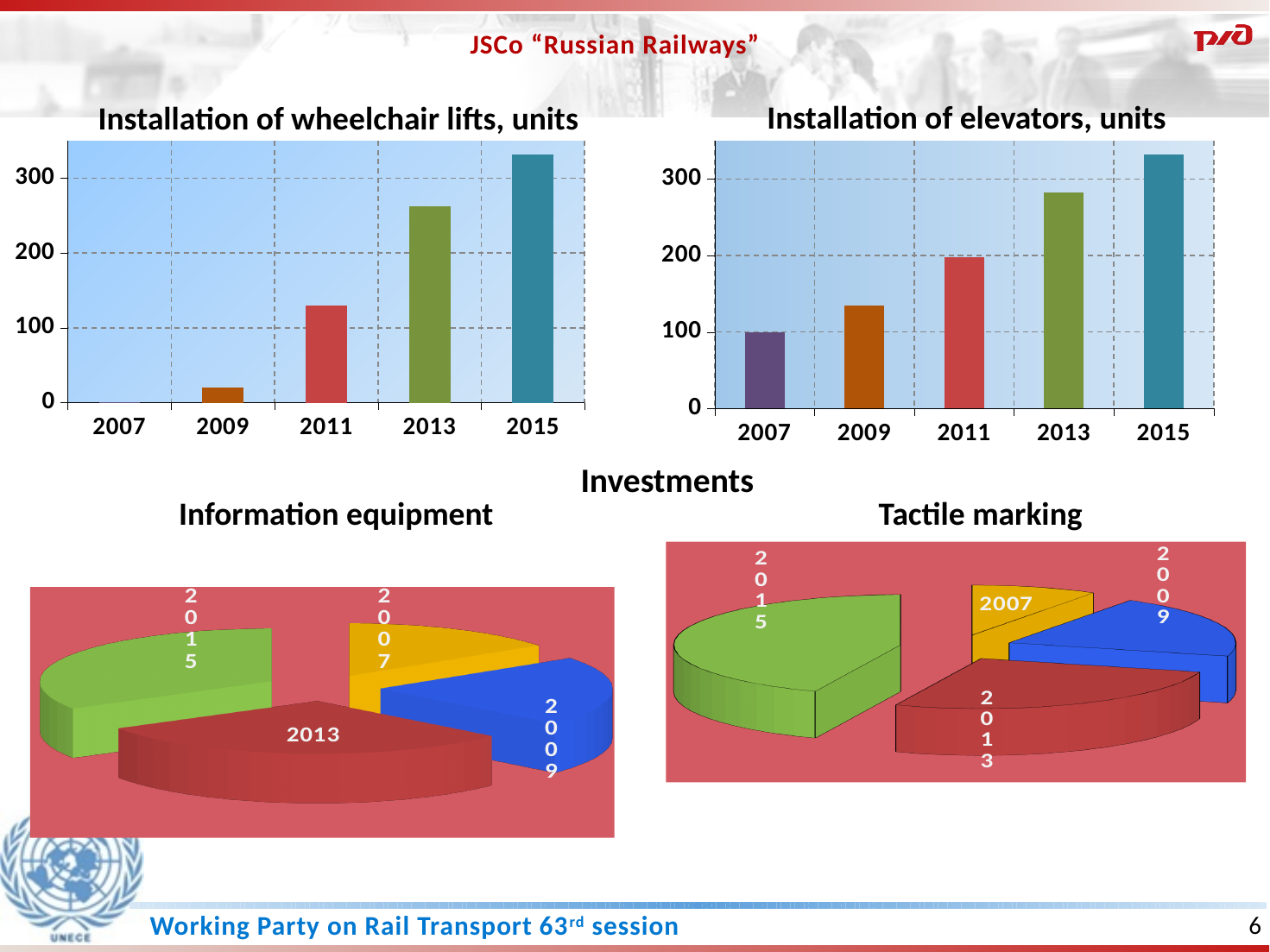
In the "Installation of elevators, units" chart, is the value for 2013 greater or less than 200? greater In the "Installation of wheelchair lifts, units" chart, which year has the highest value? 2015 In the "Installation of wheelchair lifts, units" chart, how many years are shown on the x axis? 5 In the "Installation of elevators, units" chart, which year has the highest value? 2015 In the "Installation of wheelchair lifts, units" chart, do the values rise or fall from 2007 to 2015? rise In the "Installation of wheelchair lifts, units" chart, which year has the lowest value? 2007 In the "Installation of wheelchair lifts, units" chart, is the value for 2013 greater or less than 200? greater In the "Installation of elevators, units" chart, which is larger, the value for 2009 or the value for 2013? 2013 What kind of chart is the "Installation of wheelchair lifts, units" chart? bar chart How many slices does the "Tactile marking" pie chart have? 4 What kind of chart is the "Information equipment" chart? pie chart In the "Installation of elevators, units" chart, which year has the lowest value? 2007